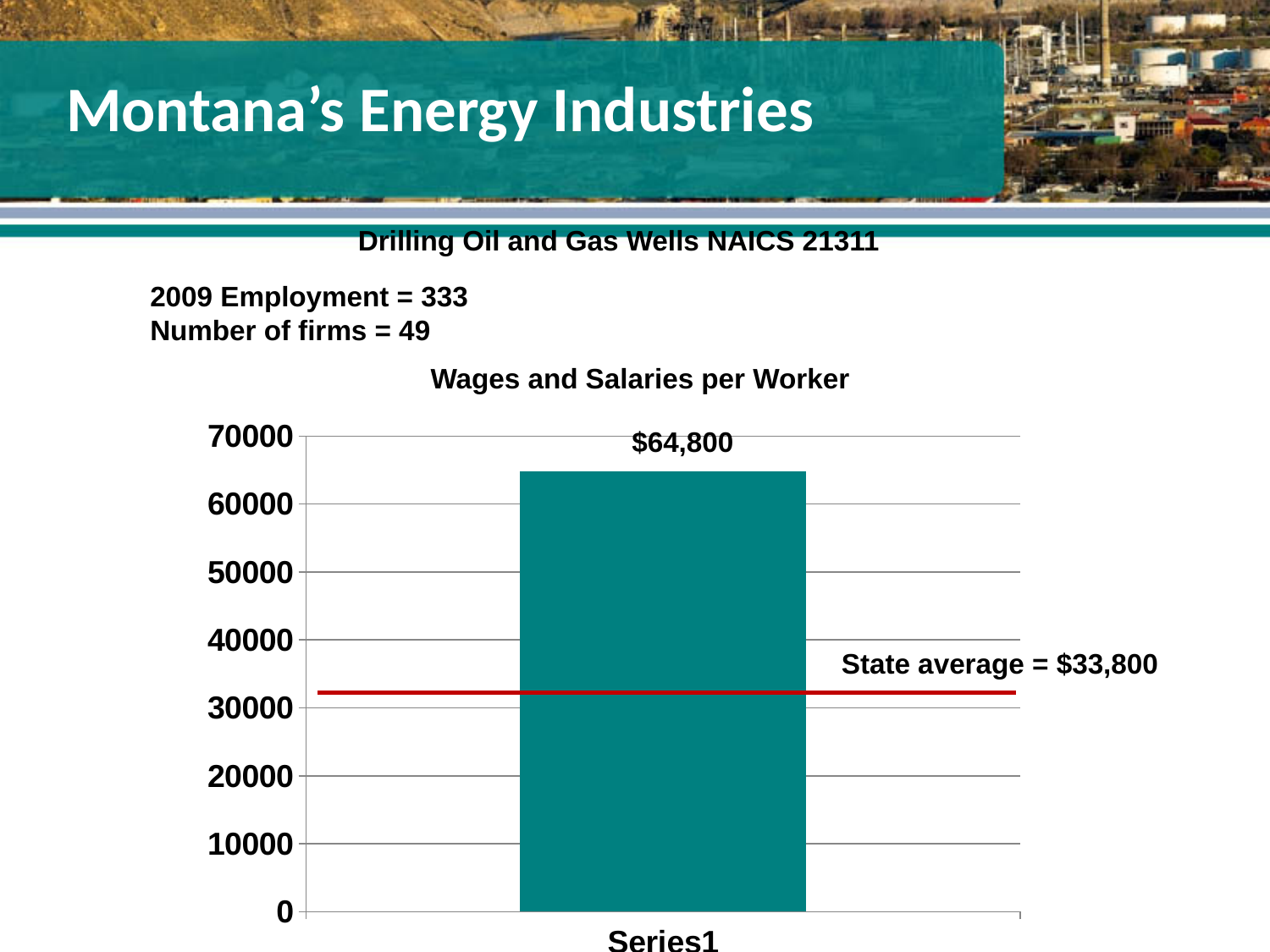
What kind of chart is shown on the slide? bar chart What is the title of the chart on the slide? Wages and Salaries per Worker What state average value is annotated on the chart? $33,800 Is the value for Series1 greater or less than 70000? less Which is larger, the Series1 wage of $64,800 or the state average of $33,800? Series1 ($64,800) Is the value for Series1 greater or less than 60000? greater What is the value of the bar labelled Series1 in the Wages and Salaries per Worker chart? $64,800 What is the category label shown on the x axis of the chart? Series1 What is the highest value shown on the vertical axis of the chart? 70000 How many bars are plotted in the Wages and Salaries per Worker chart? 1 What is the difference between the Series1 wage and the state average shown on the chart? $31,000